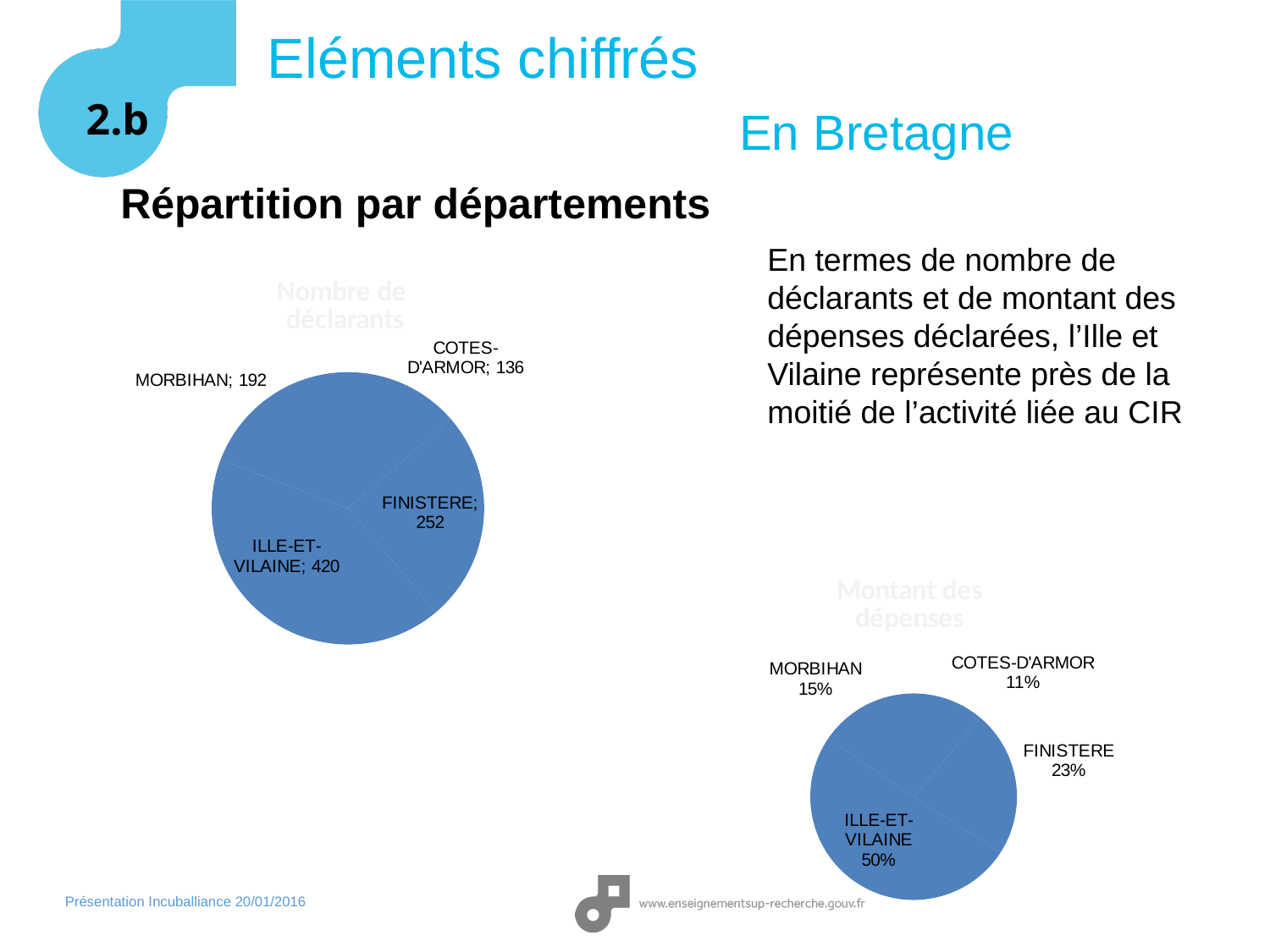
In the left pie chart, what is the difference between the values for FINISTERE and MORBIHAN? 60 In the right pie chart, which department has the smallest share? COTES-D'ARMOR In the left pie chart, what is the value for ILLE-ET-VILAINE? 420 In the left pie chart, which department has the smallest value? COTES-D'ARMOR In the left pie chart, what is the total of all four department values? 1000 In the right pie chart, which is larger, the share for FINISTERE or the share for MORBIHAN? FINISTERE In the right pie chart, what is the percentage for MORBIHAN? 15% In the left pie chart, what share of the total does ILLE-ET-VILAINE represent? 42% In the left pie chart, what is the value for COTES-D'ARMOR? 136 How many slices does the right pie chart have? 4 In the right pie chart, what is the percentage for FINISTERE? 23% In the left pie chart, which department has the largest value? ILLE-ET-VILAINE